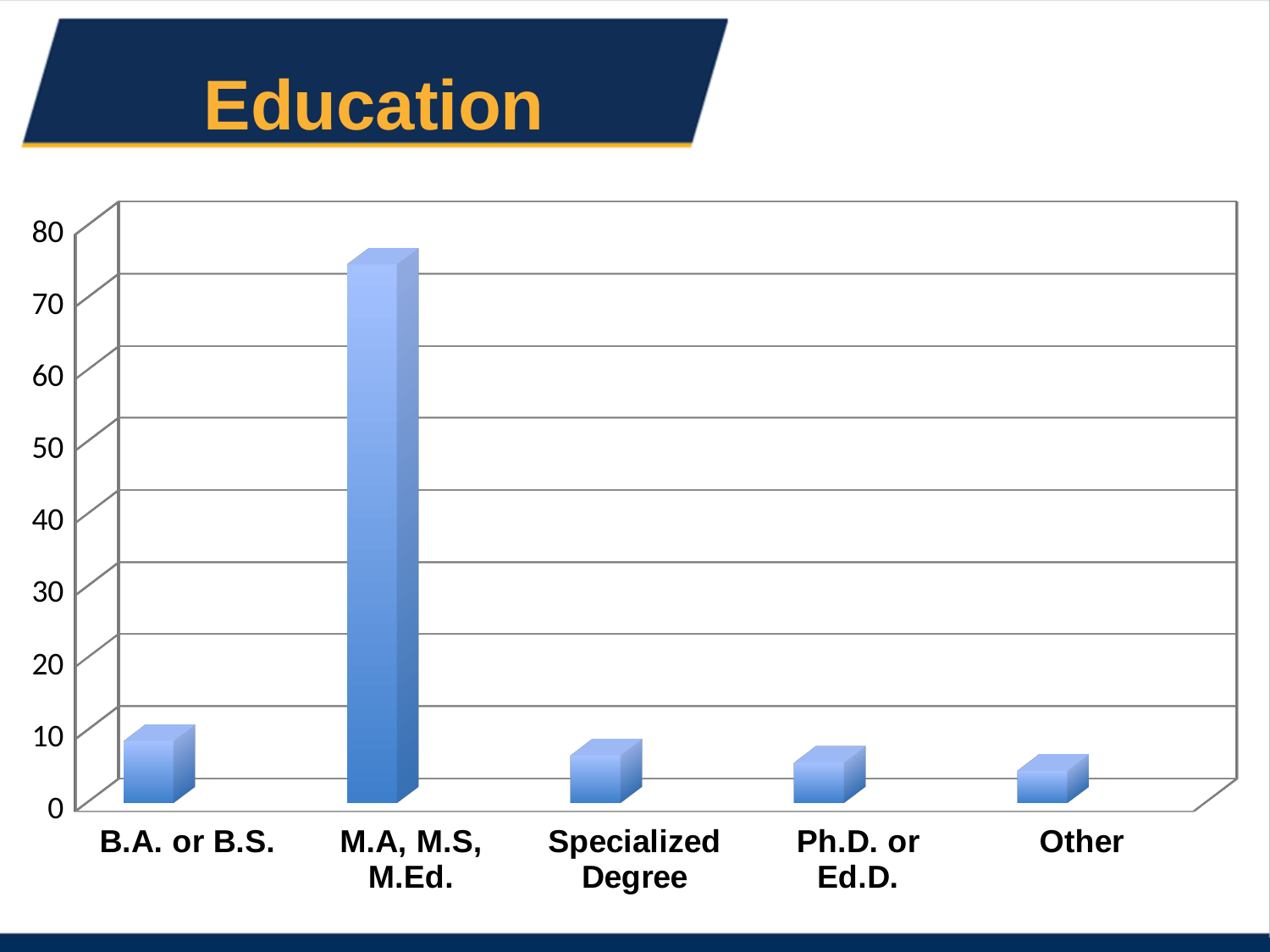
What kind of chart is shown on the slide? bar chart Which category has the highest bar in the chart? M.A, M.S, M.Ed. Which is larger, the value for B.A. or B.S. or the value for Other? B.A. or B.S. Is the value for Specialized Degree greater or less than 10? less What is the title of the slide containing the chart? Education Is the value for B.A. or B.S. greater or less than 20? less Which category has the lowest bar in the chart? Other Is the value for Other greater or less than 10? less Which is larger, the value for M.A, M.S, M.Ed. or the value for Ph.D. or Ed.D.? M.A, M.S, M.Ed. How many education categories are shown on the x axis of the chart? 5